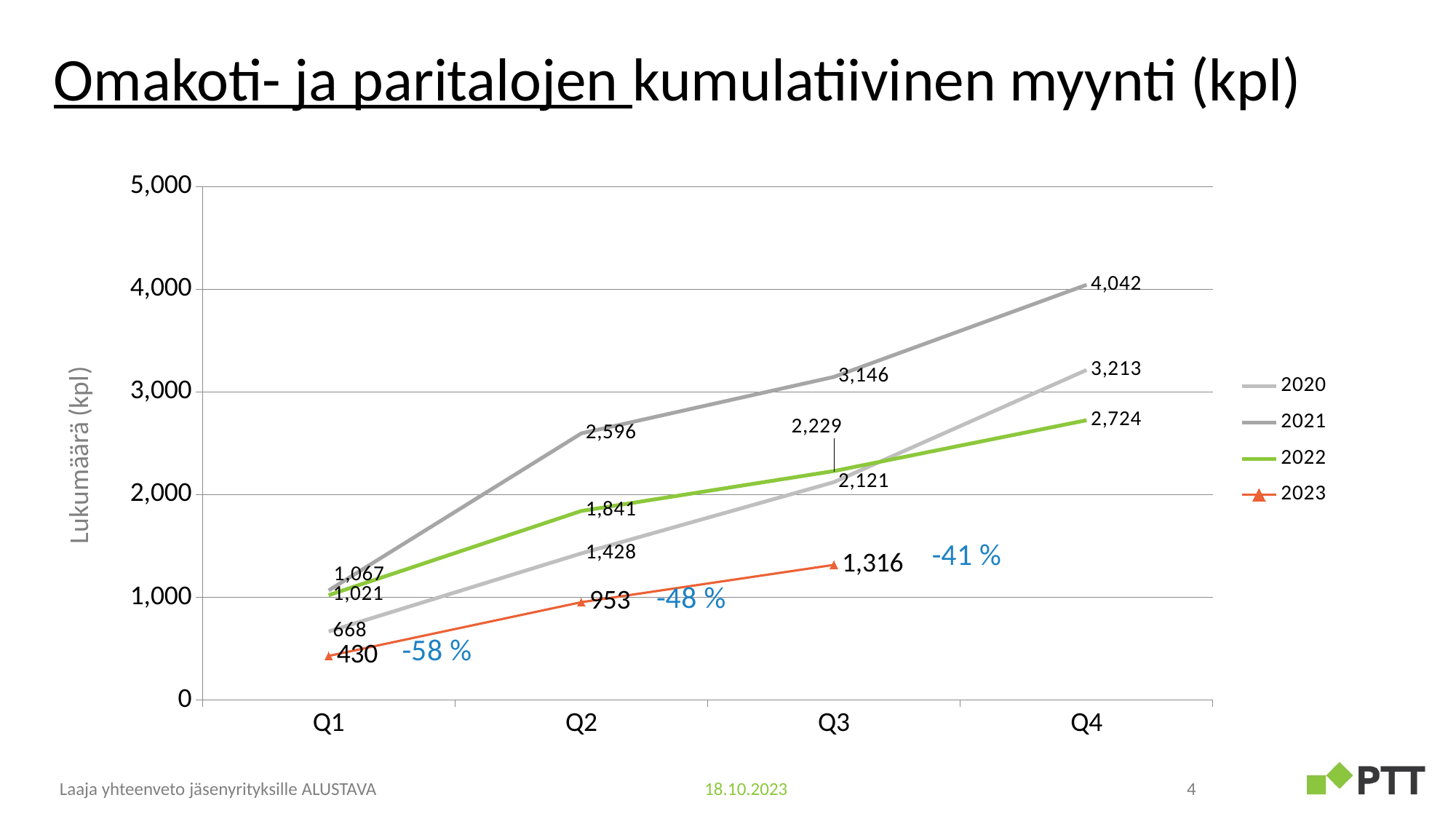
Which series has the highest value in Q4? 2021 Does the 2020 series rise or fall from Q1 to Q4? rise How many series does the legend list? 4 Which series has the lowest value in Q1? 2023 What is the value for 2020 in Q1? 668 What type of chart is shown on the slide? line chart What is the value for 2021 in Q4? 4,042 What is the value for 2022 in Q2? 1,841 What is the difference between the 2021 and 2020 values in Q4? 829 What is the value for 2023 in Q3? 1,316 Which is larger in Q3, the value for 2022 or the value for 2020? 2022 What is the label of the vertical axis? Lukumäärä (kpl)